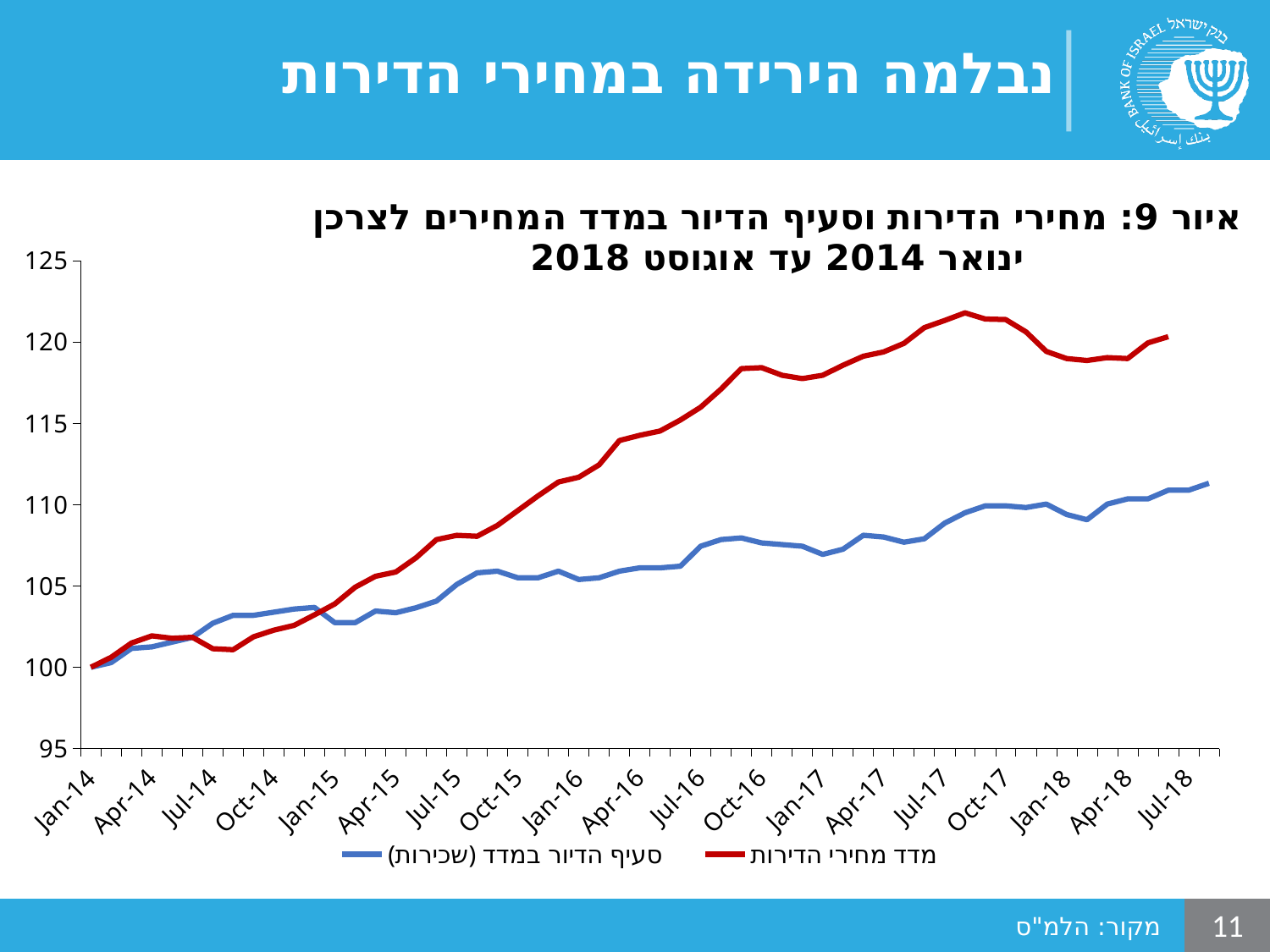
What is the value of סעיף הדיור במדד (שכירות) in Jan-14? 100 Which colour is used for the מדד מחירי הדירות line? red Is the value of סעיף הדיור במדד (שכירות) in Jul-18 greater or less than 110? greater What is the value of מדד מחירי הדירות in Jan-14? 100 What kind of chart is shown on the slide? line chart Overall, does סעיף הדיור במדד (שכירות) rise or fall from Jan-14 to Jul-18? rise Is the value of סעיף הדיור במדד (שכירות) in Jan-16 greater or less than 110? less Is the value of מדד מחירי הדירות in Oct-16 greater or less than 115? greater Which series reaches the highest value on the chart? מדד מחירי הדירות How many series does the legend list? 2